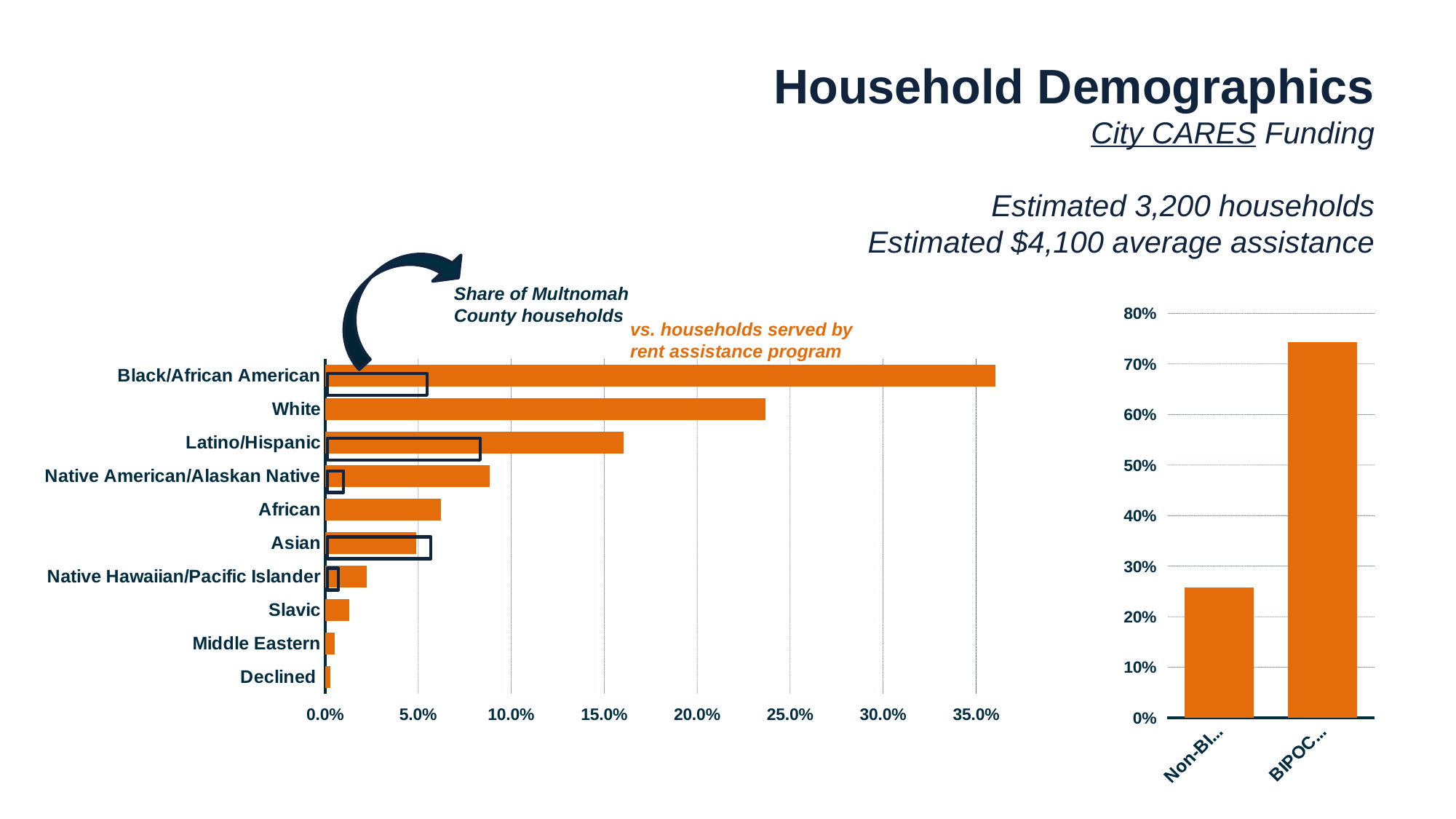
On the right chart, how many bars are plotted? 2 On the left chart, is the value for Native American/Alaskan Native greater or less than 10.0%? less On the left chart, which category has the lowest value? Declined On the right chart, is the value for BIPOC greater or less than 70%? greater What is the title of the slide containing the charts? Household Demographics On the left chart, is the value for Black/African American greater or less than 30.0%? greater What kind of chart is the left chart? Bar chart On the left chart, which category has the highest share of households served by the rent assistance program? Black/African American On the left chart, which is larger, the value for African or the value for Asian? African On the left chart, which is larger, the value for White or the value for Latino/Hispanic? White On the left chart, how many categories are listed on the vertical axis? 10